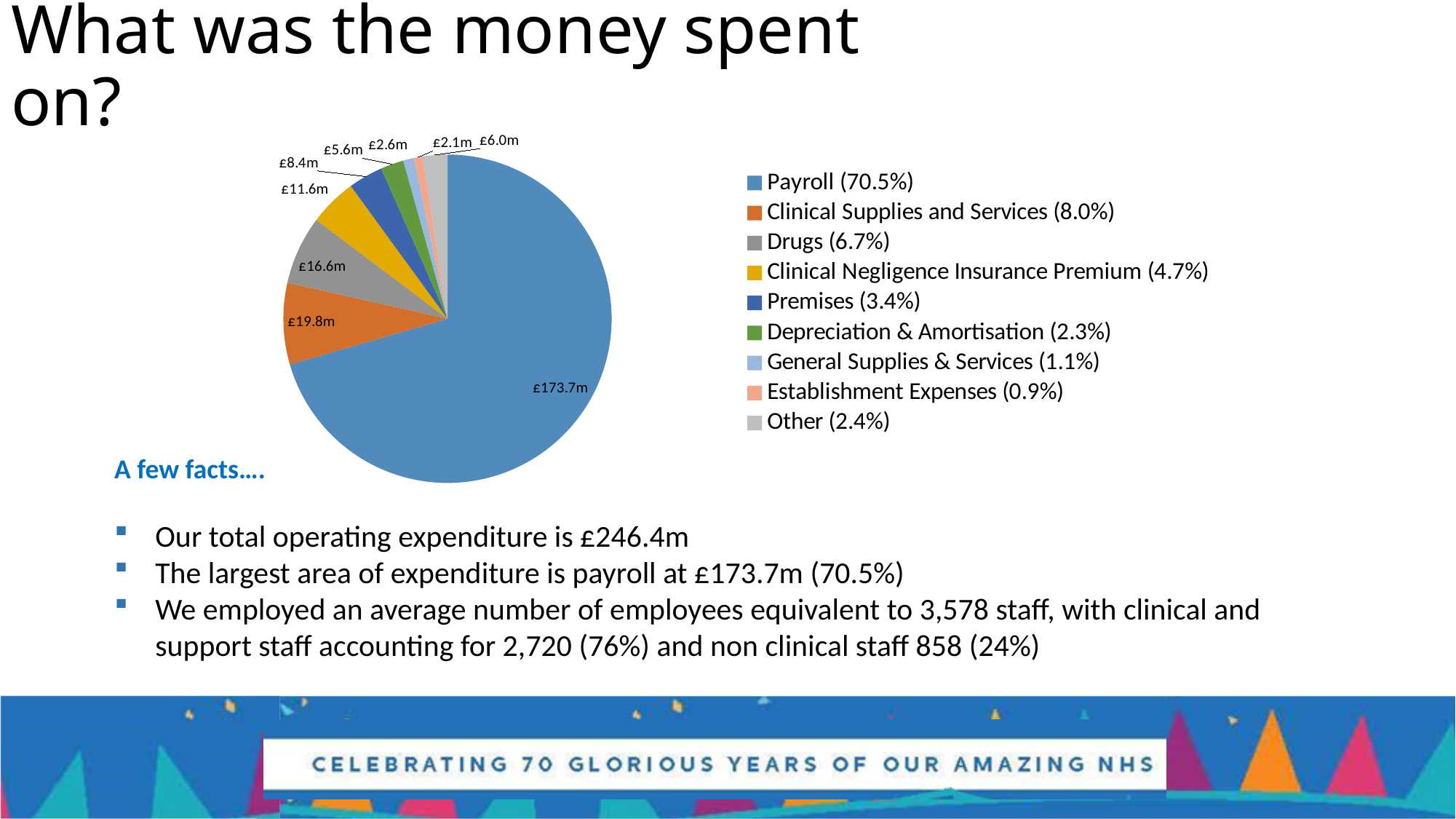
What is the value of the Premises slice in the pie chart? £8.4m Which is larger, the Other slice or the Depreciation & Amortisation slice? Other Which category has the largest slice of the pie chart? Payroll What kind of chart is shown on the slide? pie chart Which category has the smallest slice of the pie chart? Establishment Expenses What share of the pie does Clinical Supplies and Services represent? 8.0% What is the difference between the Clinical Supplies and Services slice and the Drugs slice? £3.2m What is the value of the Clinical Negligence Insurance Premium slice? £11.6m What is the value of the Drugs slice in the pie chart? £16.6m What is the value of the Payroll slice in the pie chart? £173.7m What share of the pie does Depreciation & Amortisation represent? 2.3% How many slices does the pie chart have? 9